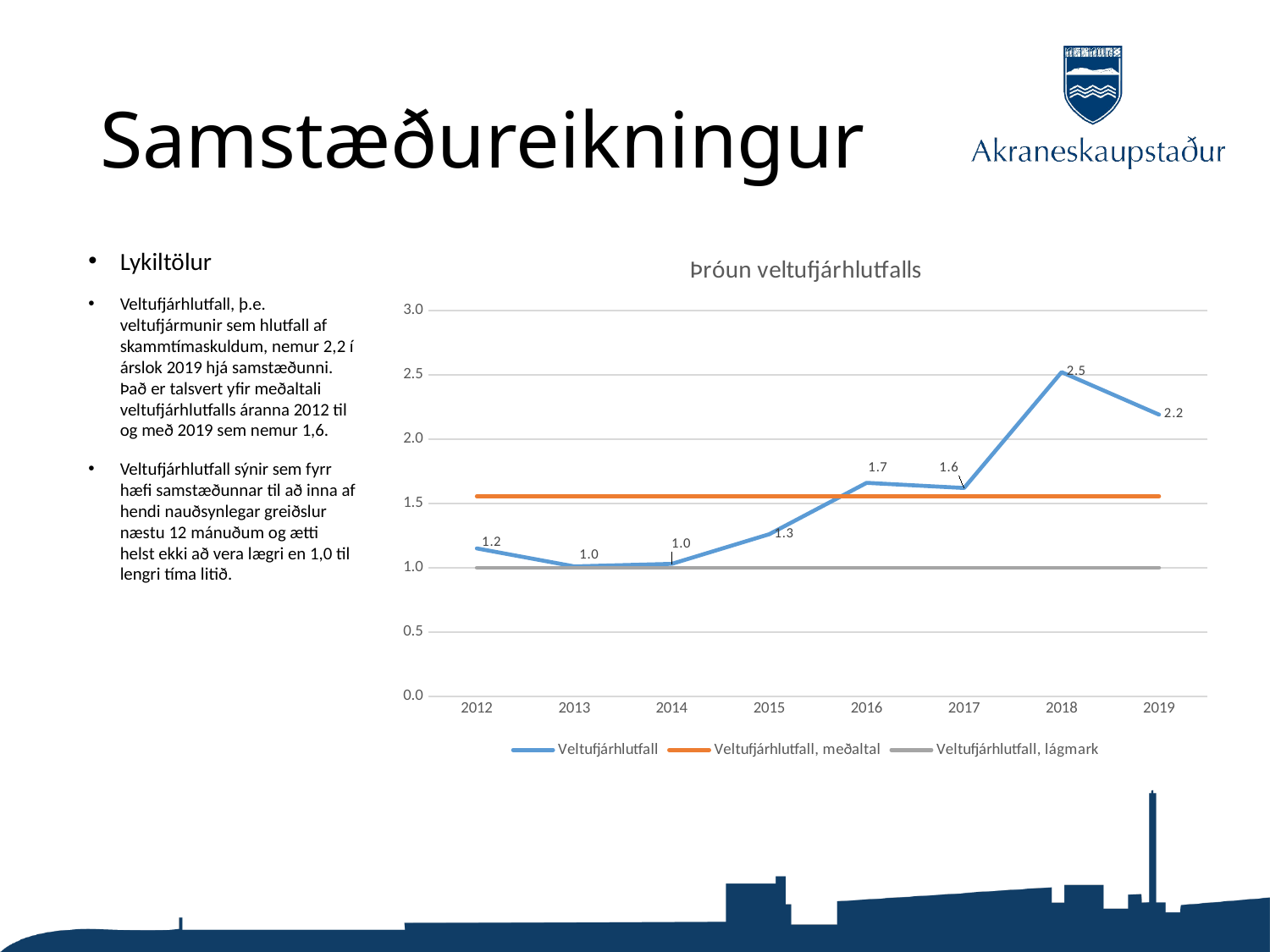
What kind of chart is shown on the slide? line chart What is the value of Veltufjárhlutfall in 2019? 2.2 Does the Veltufjárhlutfall line rise or fall from 2014 to 2018? rise Is the value of the Veltufjárhlutfall, meðaltal line greater or less than 1.5? greater What is the value of Veltufjárhlutfall in 2015? 1.3 How many years are shown on the x axis of the chart? 8 How many series does the chart legend list? 3 What is the value of Veltufjárhlutfall in 2018? 2.5 In which year is Veltufjárhlutfall highest? 2018 What is the difference between the Veltufjárhlutfall values for 2018 and 2019? 0.3 Which year has the larger Veltufjárhlutfall value, 2016 or 2017? 2016 What is the value of Veltufjárhlutfall in 2012? 1.2